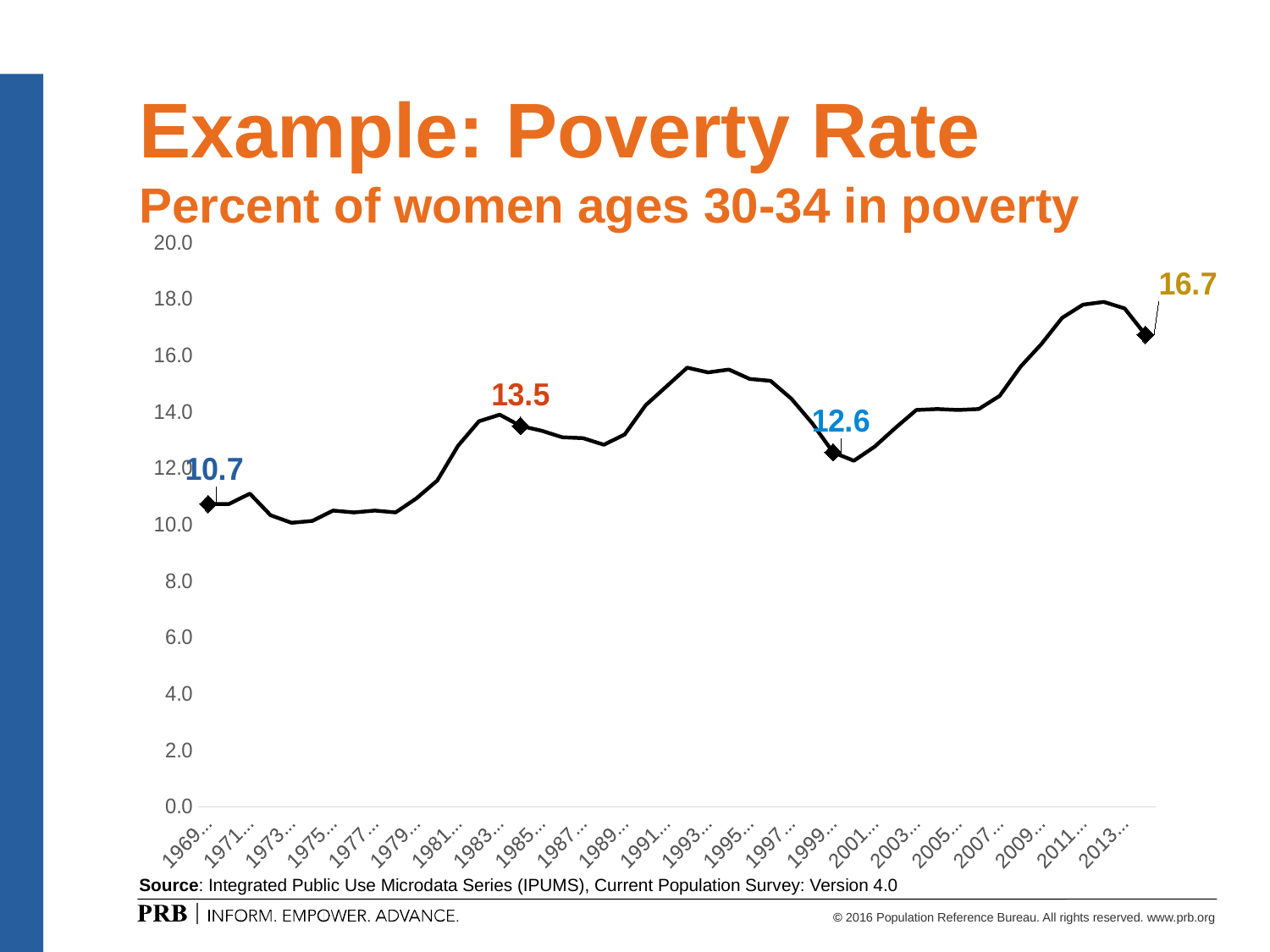
Overall, does the poverty rate rise or fall from 1969 to the end of the series? rise Which of the four labeled values on the chart is the lowest? 10.7 What value is labeled on the line at the 1985 point? 13.5 What kind of chart is shown on the slide? line chart What is the difference between the last labeled value (16.7) and the first labeled value (10.7)? 6.0 What value is labeled at the last (most recent) data point on the line? 16.7 Is the value for 1993 greater or less than 14.0? greater What value is labeled on the line at the 1999 point? 12.6 What is the poverty rate for women ages 30-34 at the first data point (1969)? 10.7 Which of the four labeled values on the chart is the highest? 16.7 Which labeled value is larger: the one at 1985 or the one at 1999? 13.5 (1985) What is the difference between the labeled values 13.5 and 12.6? 0.9